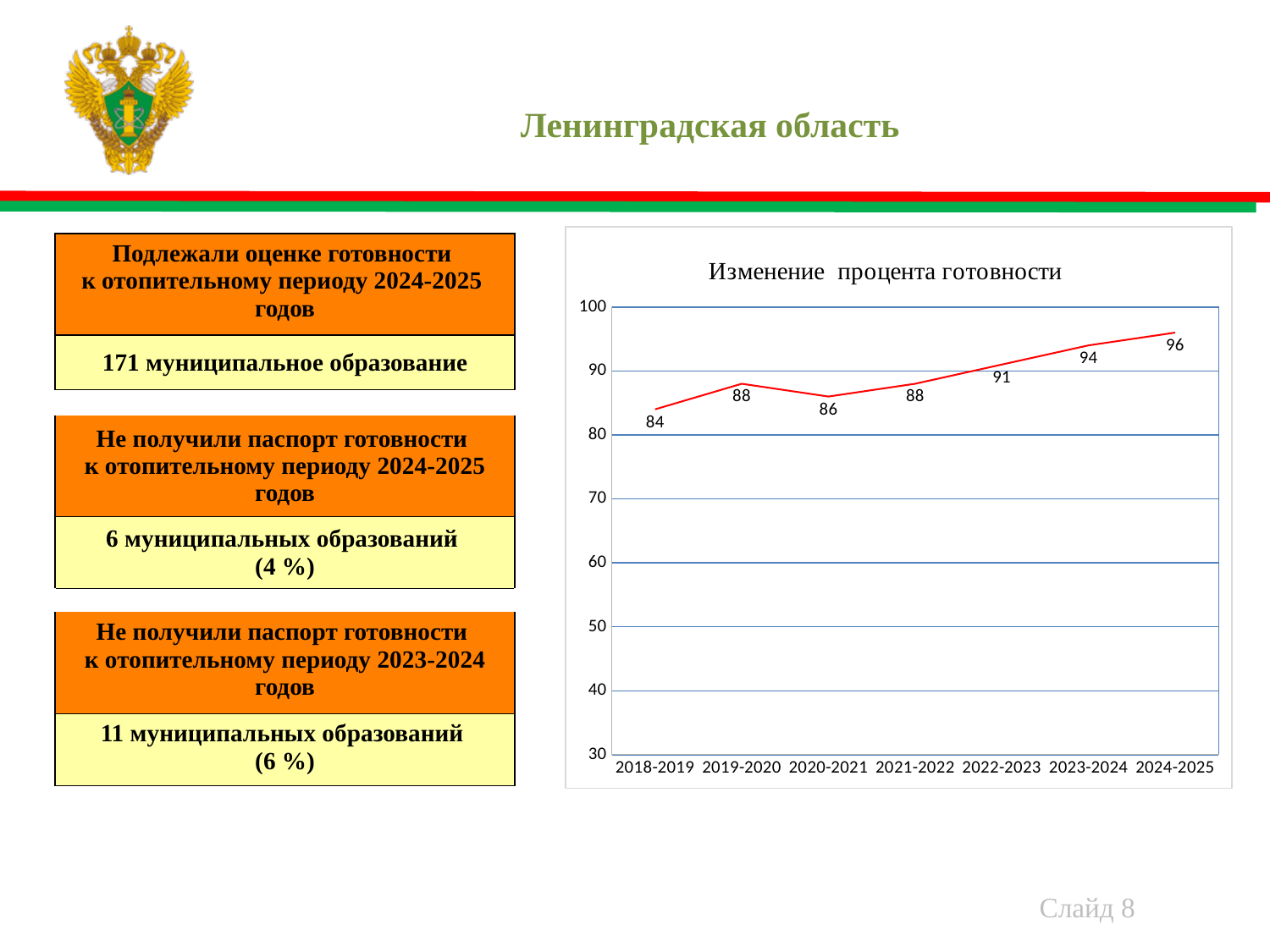
What is the value for 2022-2023 in the chart? 91 What is the difference between the values for 2024-2025 and 2018-2019? 12 Which period has the highest value in the chart? 2024-2025 What is the value for 2018-2019 in the chart? 84 Which is larger, the value for 2019-2020 or the value for 2020-2021? 2019-2020 Do the values generally rise or fall from 2018-2019 to 2024-2025? rise How many periods are plotted on the x axis of the chart? 7 What is the value for 2024-2025 in the chart? 96 What kind of chart is shown on the slide? line chart Is the value for 2023-2024 greater or less than 90? greater What is the title of the chart? Изменение процента готовности Which period has the lowest value in the chart? 2018-2019